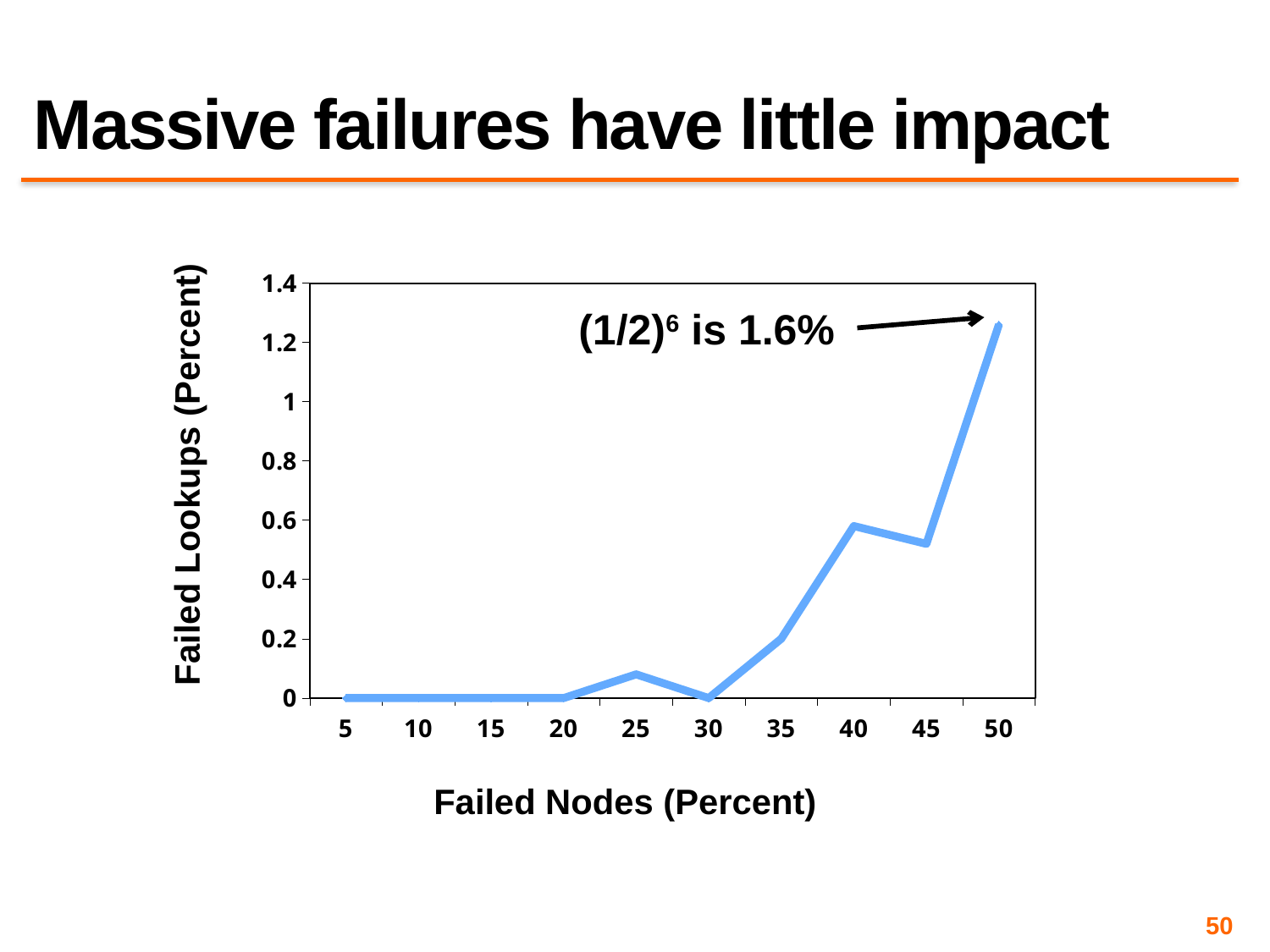
Which has a higher Failed Lookups value: 40 percent failed nodes or 50 percent failed nodes? 50 What kind of chart is shown on the slide? line chart Is the Failed Lookups value at 50 percent failed nodes greater or less than 1? greater How many data points are plotted on the line? 10 What is the Failed Lookups (Percent) value when Failed Nodes is 30? 0 At which value of Failed Nodes (Percent) is the Failed Lookups value highest? 50 What is the label of the x axis? Failed Nodes (Percent) Is the Failed Lookups value at 25 percent failed nodes greater or less than 0.2? less What is the title of the slide containing the chart? Massive failures have little impact What is the Failed Lookups (Percent) value when Failed Nodes is 10? 0 Overall, do Failed Lookups rise or fall as Failed Nodes increases from 5 to 50? rise Is the Failed Lookups value at 40 percent failed nodes greater or less than 0.4? greater